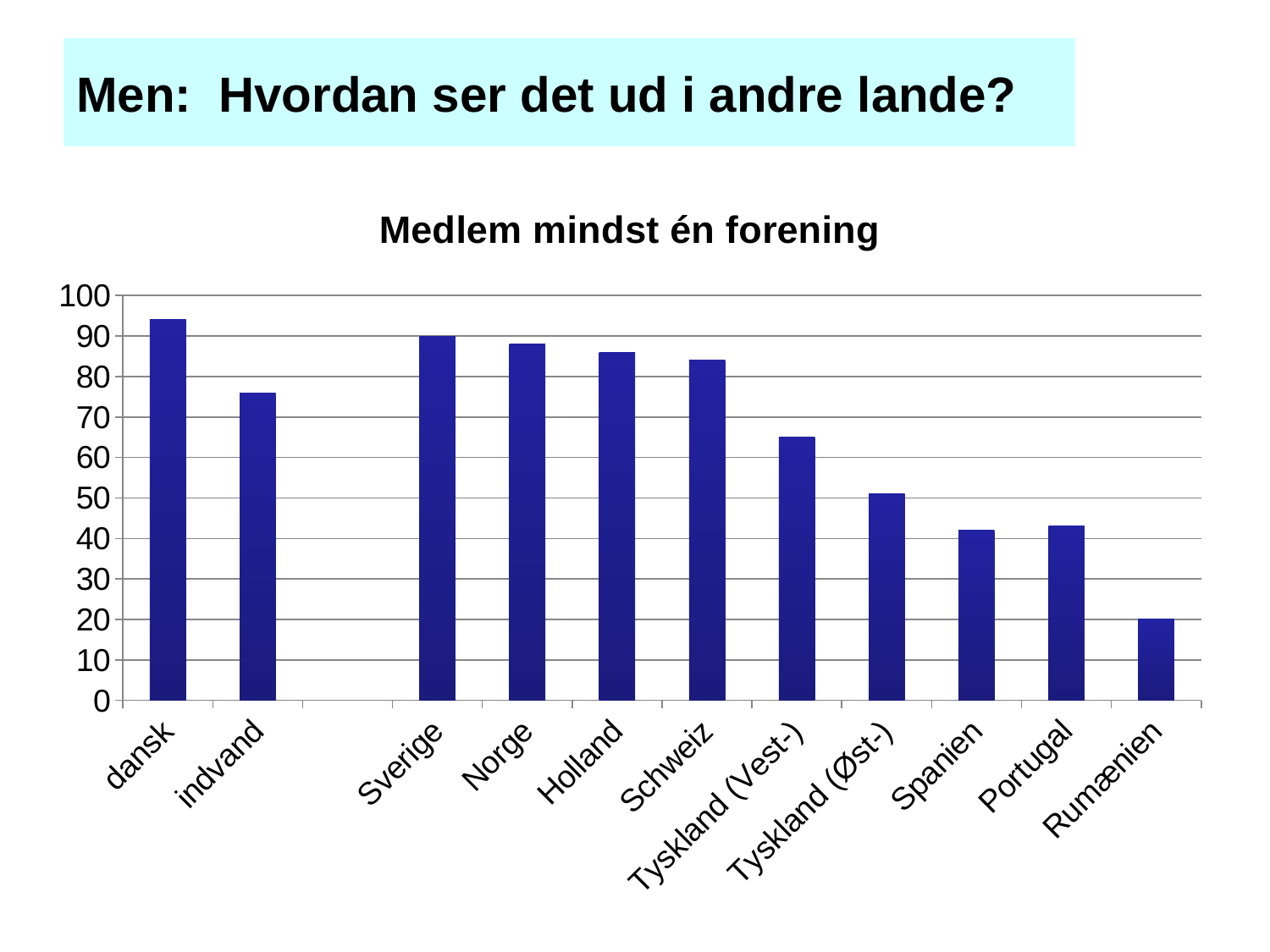
Do the values rise or fall moving from Sverige to Rumænien along the x axis? fall What is the title of the chart? Medlem mindst én forening Is the value for Spanien greater or less than 50? less Which is larger, the value for dansk or the value for indvand? dansk Is the value for dansk greater or less than 90? greater What kind of chart is shown on the slide? bar chart Which category has the lowest bar? Rumænien Which category has the highest bar? dansk Is the value for Tyskland (Vest-) greater or less than 60? greater How many bars (categories) are plotted in the chart? 11